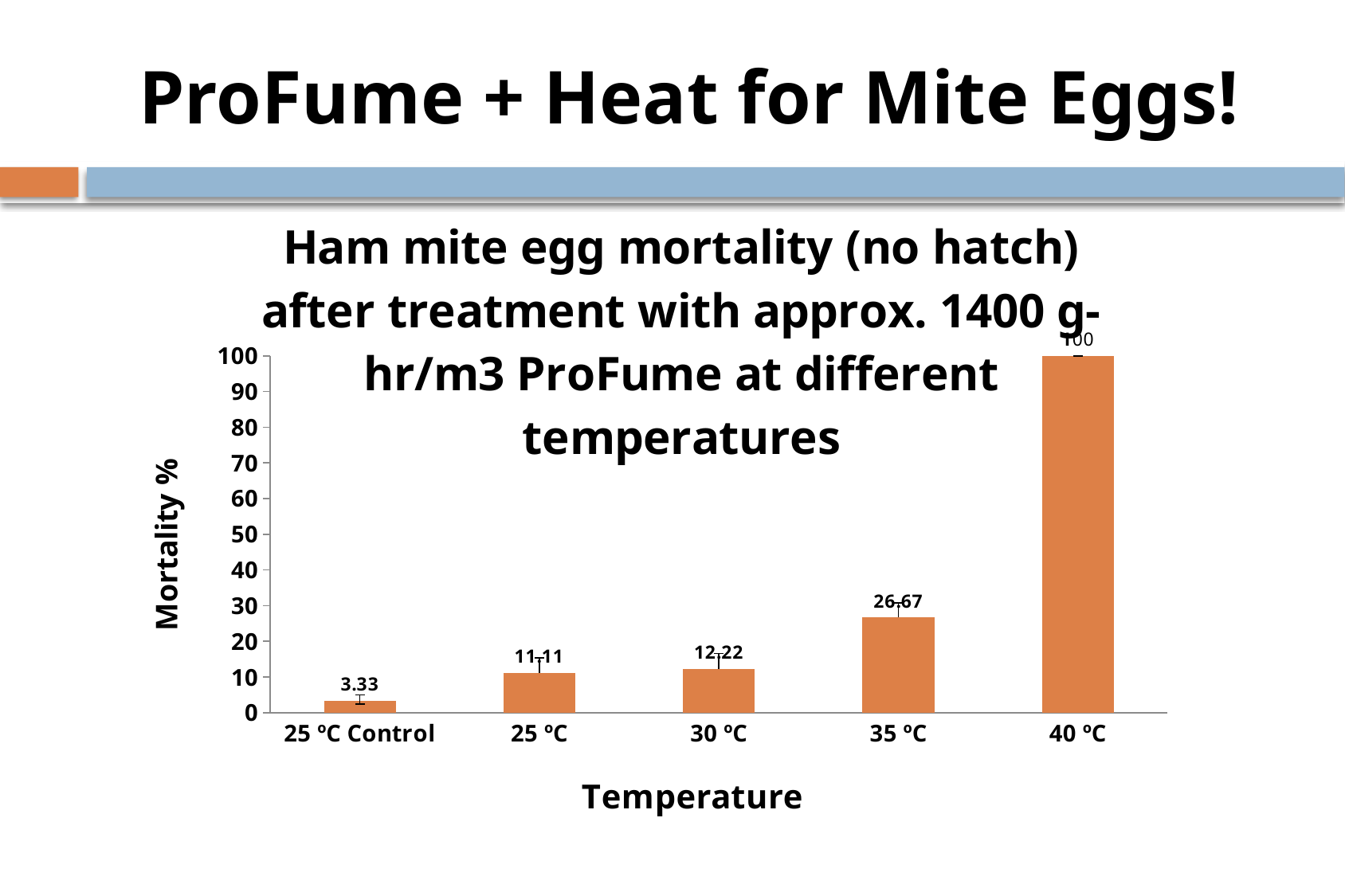
What is the mortality % for 30 ºC? 12.22 Is the value for 40 ºC greater or less than 90? greater Which temperature category has the highest mortality %? 40 ºC What is the difference in mortality % between 35 ºC and 30 ºC? 14.45 How many temperature categories are shown on the x axis? 5 What is the label of the y axis? Mortality % What kind of chart is shown on the slide? bar chart What is the mortality % for 25 ºC Control? 3.33 Which temperature category has the lowest mortality %? 25 ºC Control What is the mortality % for 35 ºC? 26.67 What is the mortality % for 25 ºC? 11.11 Which has a higher mortality %, 35 ºC or 25 ºC? 35 ºC